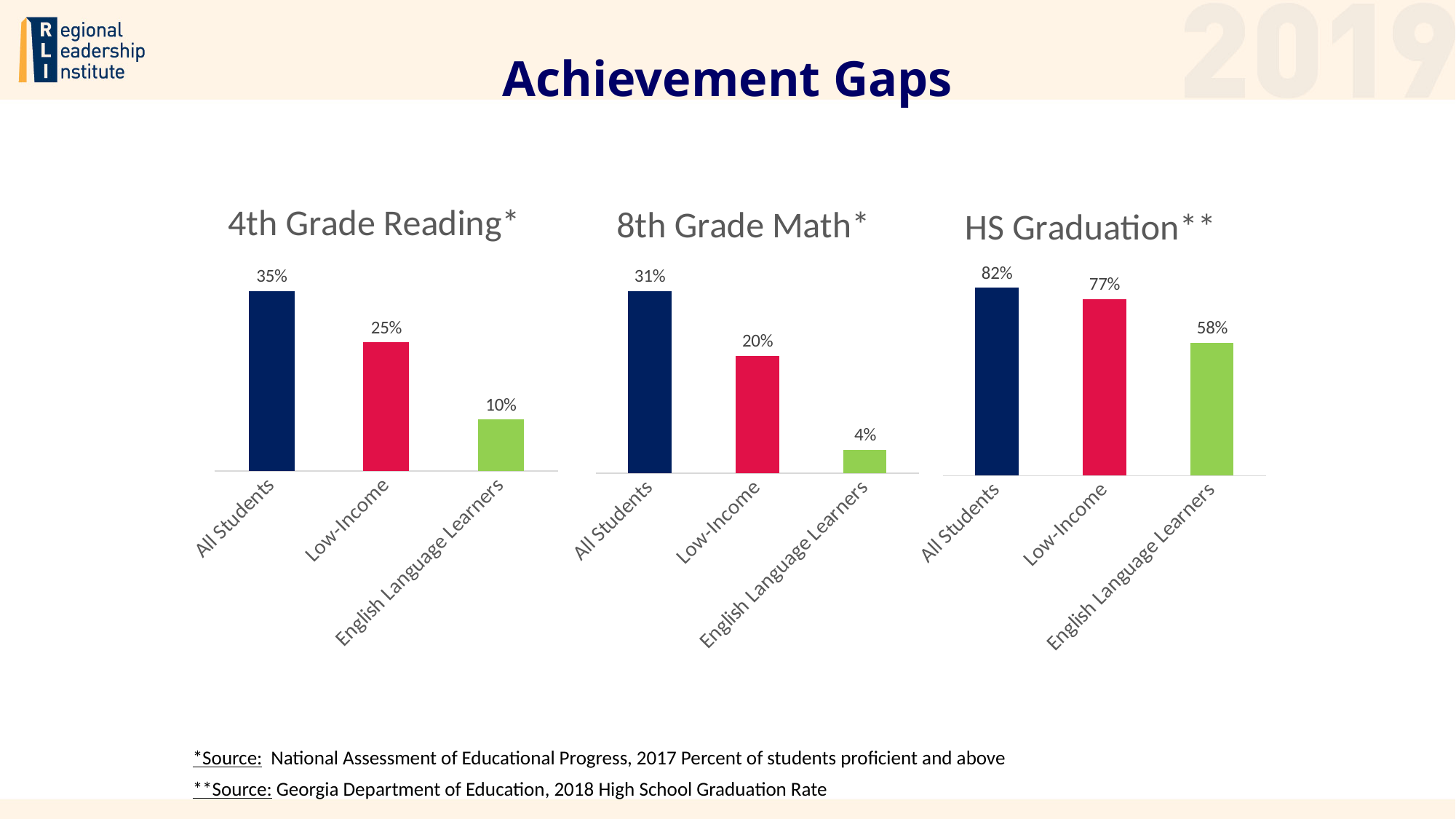
In the 8th Grade Math chart, do the values rise or fall from left to right? Fall How many categories are shown in the 4th Grade Reading chart? 3 In the 8th Grade Math chart, which category has the highest value? All Students In the 8th Grade Math chart, which is larger, the value for Low-Income or the value for English Language Learners? Low-Income In the HS Graduation chart, which category has the lowest value? English Language Learners What colour is the Low-Income bar in the 4th Grade Reading chart? Red In the 4th Grade Reading chart, what is the value for Low-Income students? 25% What kind of chart is the HS Graduation chart? Bar chart In the HS Graduation chart, what is the difference between All Students and Low-Income? 5% In the 4th Grade Reading chart, what is the difference between All Students and English Language Learners? 25% In the HS Graduation chart, what is the value for All Students? 82% In the 8th Grade Math chart, what is the value for English Language Learners? 4%